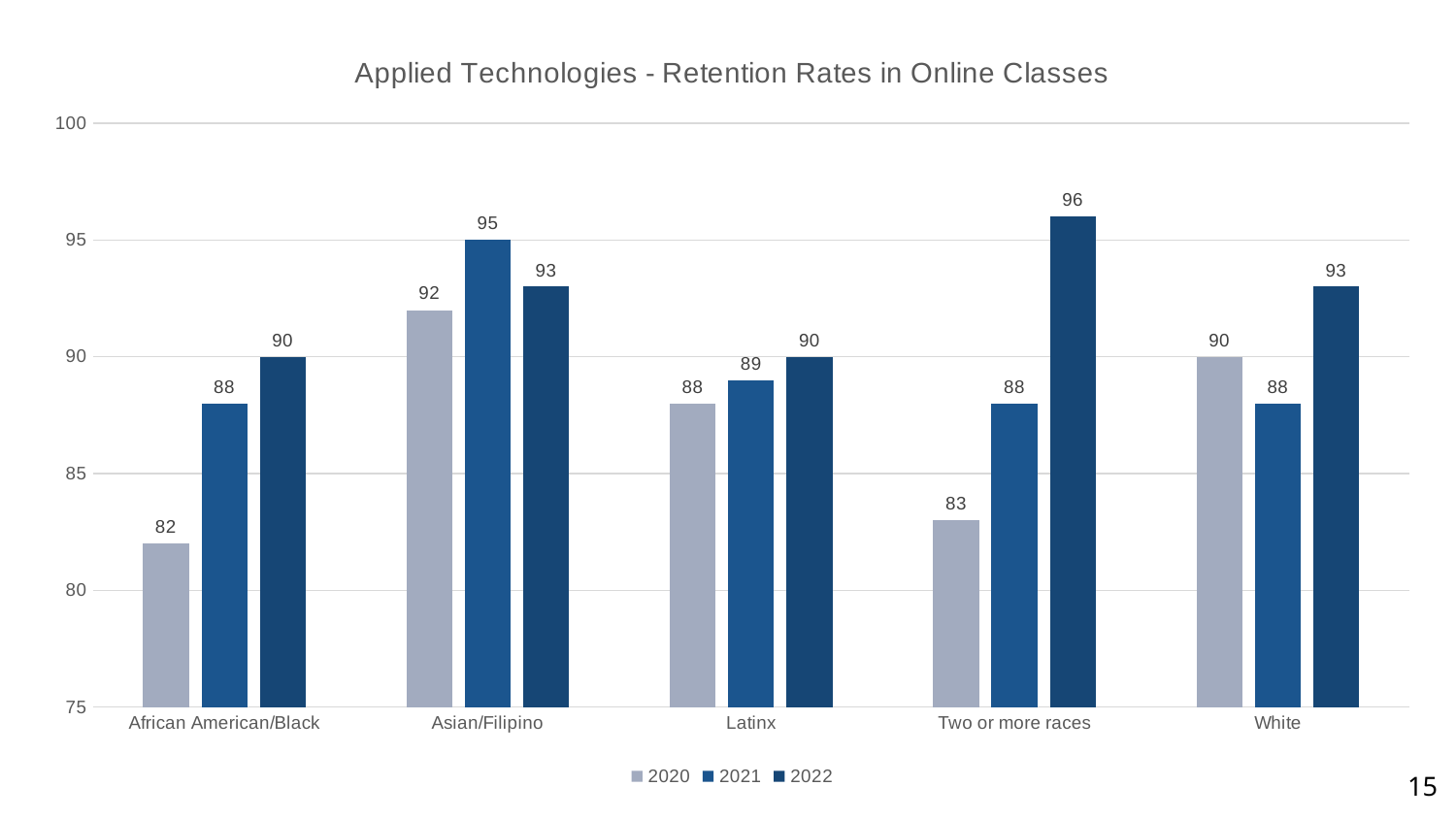
How many series does the legend list? 3 Which category has the highest 2022 retention rate? Two or more races What is the difference between the 2022 and 2020 retention rates for Two or more races? 13 Which is larger for White students: the 2020 rate or the 2021 rate? 2020 What kind of chart is shown on the slide? Bar chart What is the 2020 retention rate for African American/Black students? 82 What is the 2021 retention rate for Asian/Filipino students? 95 How many categories are shown on the x axis? 5 Which category has the lowest 2020 retention rate? African American/Black Do the retention rates for Latinx students rise or fall from 2020 to 2022? Rise What is the title of the chart? Applied Technologies - Retention Rates in Online Classes What is the 2022 retention rate for Two or more races? 96